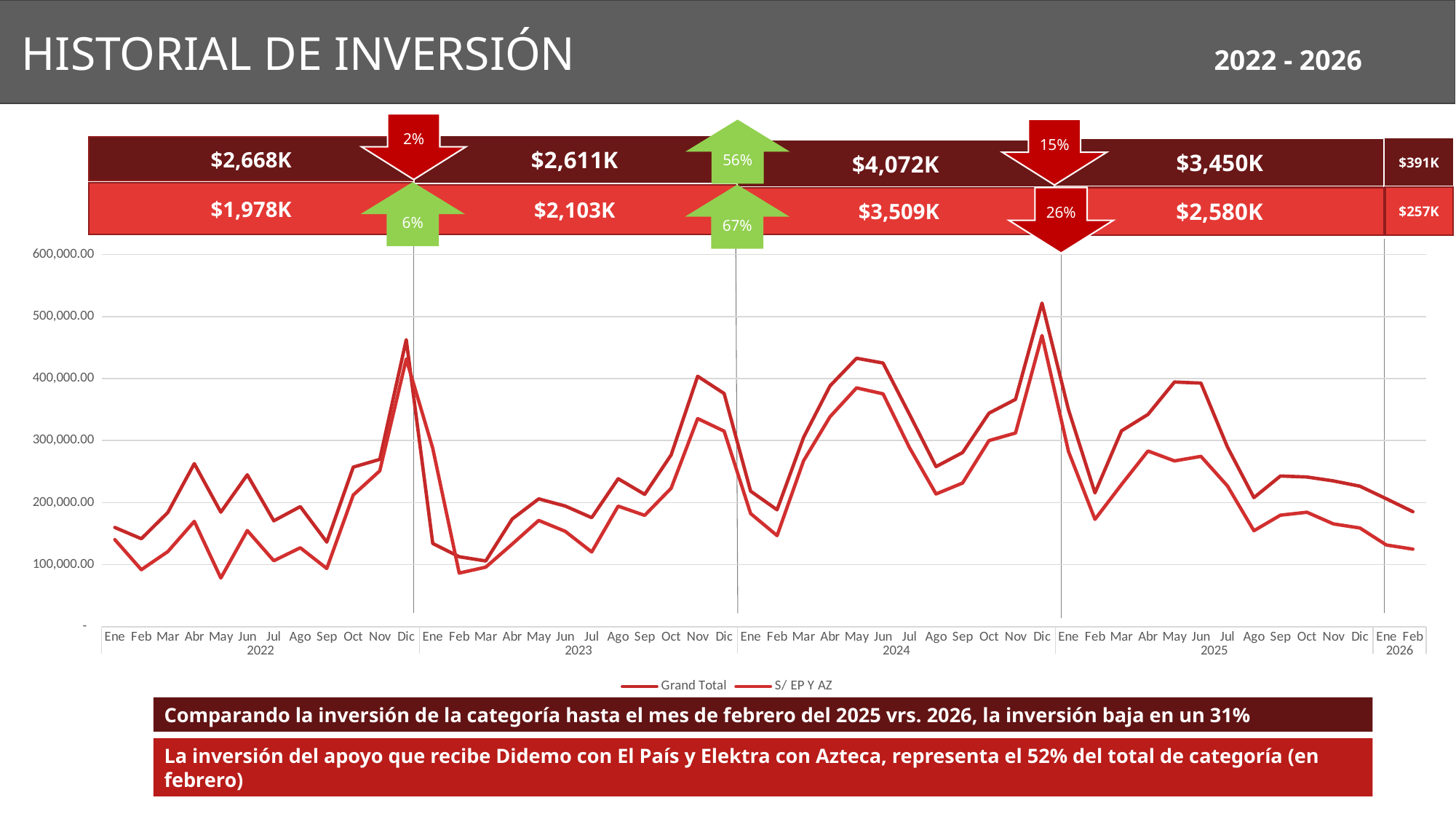
What kind of chart is shown on the slide? line chart Is the Grand Total value for Nov 2023 greater or less than 300,000.00? greater In which month and year does the Grand Total line reach its highest point? Dic 2024 How many series does the chart legend list? 2 Does the Grand Total line rise or fall from Feb 2023 to May 2023? rise Does the Grand Total line rise or fall from Sep 2025 to Feb 2026? fall How many months of 2026 are plotted on the x axis? 2 Is the Grand Total value for Ene 2022 greater or less than 200,000.00? less What are the two series named in the chart legend? Grand Total and S/ EP Y AZ Is the Grand Total value for Dic 2024 greater or less than 400,000.00? greater At Dic 2024, which series has the larger value, Grand Total or S/ EP Y AZ? Grand Total